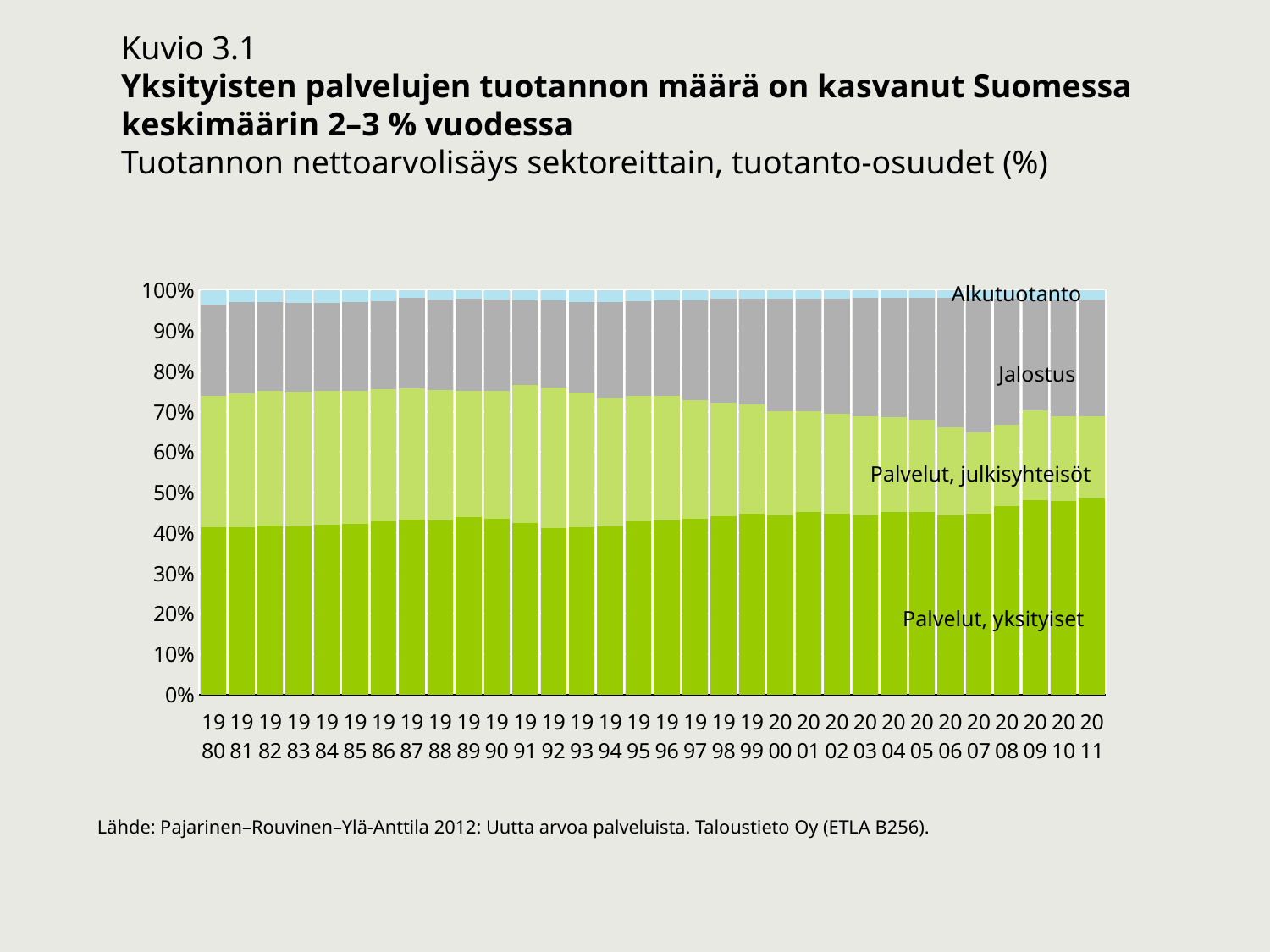
Does the share of Palvelut, yksityiset rise or fall from 1980 to 2011? Rise Which sector forms the top segment of each bar? Alkutuotanto Is the share of Palvelut, yksityiset in 1980 greater or less than 40%? greater How many sectors (series) are labelled in the chart? 4 Which year has the larger share of Palvelut, yksityiset, 1980 or 2011? 2011 What kind of chart is shown on the slide? Stacked bar chart What is the total of each stacked bar in the chart? 100% How many years (bars) are shown on the x axis of the chart? 32 Is the combined share of the two service sectors (top of the Palvelut, julkisyhteisöt segment) in 2006 greater or less than 70%? less Is the share of Palvelut, yksityiset in 2011 greater or less than 40%? greater Which sector forms the bottom segment of each bar? Palvelut, yksityiset